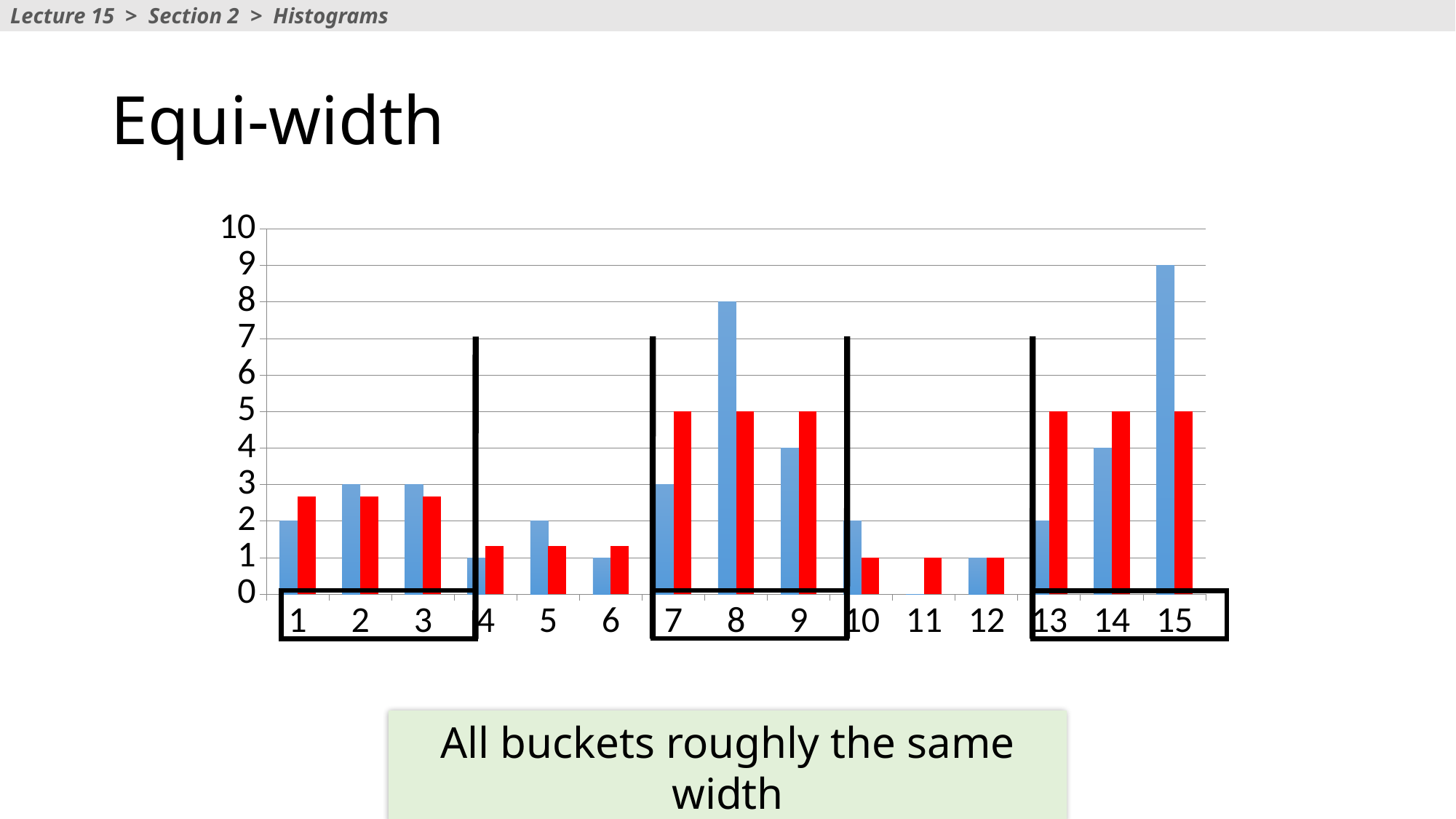
What kind of chart is shown on the slide? bar chart Which is larger, the blue bar for category 9 or the blue bar for category 12? category 9 What is the value of the blue bar for category 15? 9 Which category has the tallest blue bar? 15 What is the title of the slide containing the chart? Equi-width What is the value of the blue bar for category 14? 4 What is the value of the blue bar for category 8? 8 What is the value of the red bar for category 7? 5 Which category has the lowest blue bar? 11 How many categories are shown on the x axis? 15 Is the value of the red bar for category 5 greater or less than 2? less What is the difference between the blue bar for category 15 and the blue bar for category 8? 1